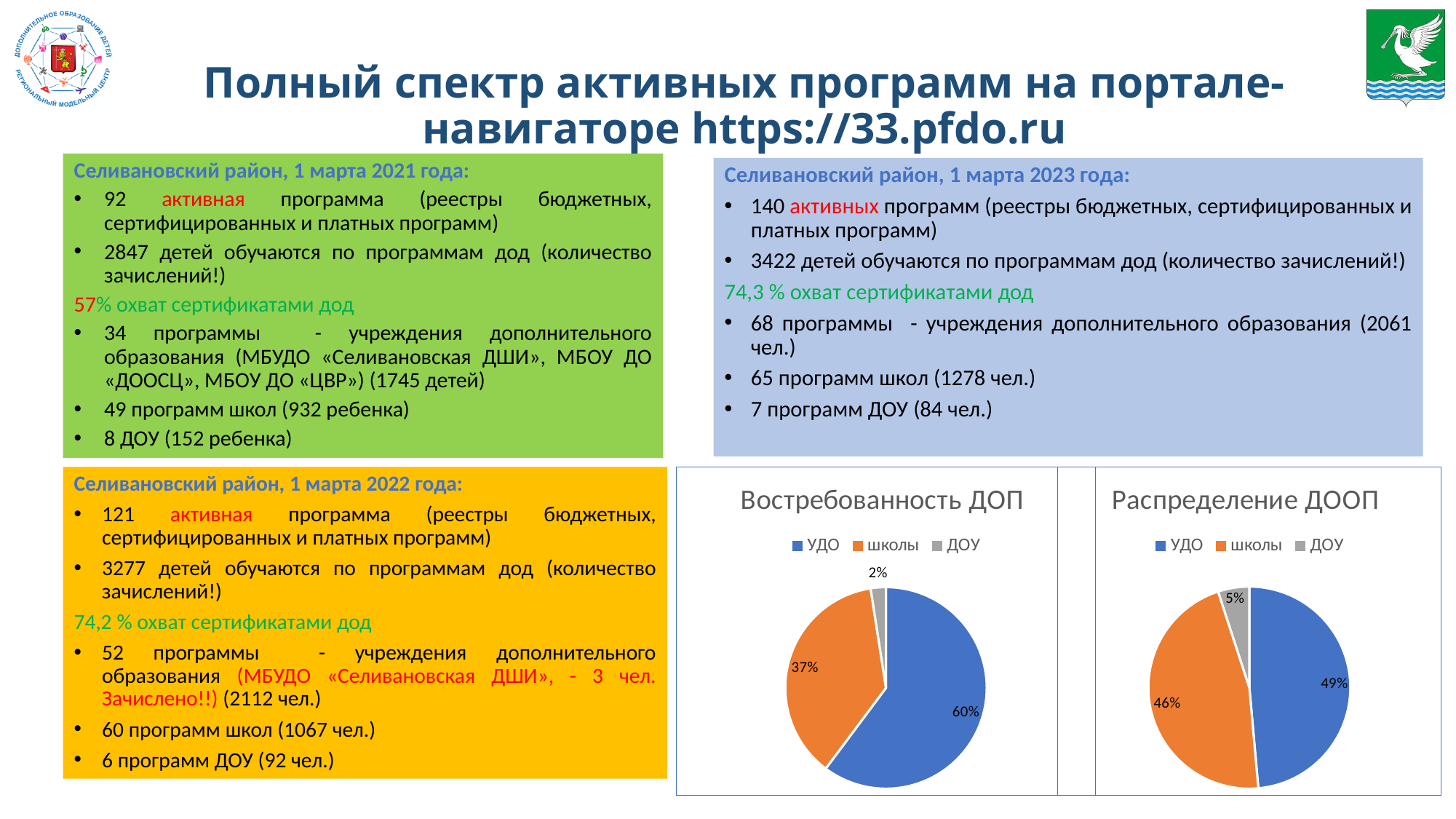
In the chart titled "Востребованность ДОП", what is the difference between the shares of УДО and школы? 23% In the chart titled "Распределение ДООП", what share does школы have? 46% How many entries does the legend of the chart titled "Востребованность ДОП" list? 3 In the chart titled "Распределение ДООП", what share does ДОУ have? 5% In the chart titled "Востребованность ДОП", what share does школы have? 37% In the chart titled "Распределение ДООП", which category has the smallest share? ДОУ In the chart titled "Востребованность ДОП", what share does ДОУ have? 2% In the chart titled "Распределение ДООП", what share does УДО have? 49% In the chart titled "Распределение ДООП", what is the difference between the shares of школы and ДОУ? 41% In the chart titled "Востребованность ДОП", which category has the largest share? УДО In the chart titled "Востребованность ДОП", what share does УДО have? 60% What type of chart is "Распределение ДООП"? Pie chart